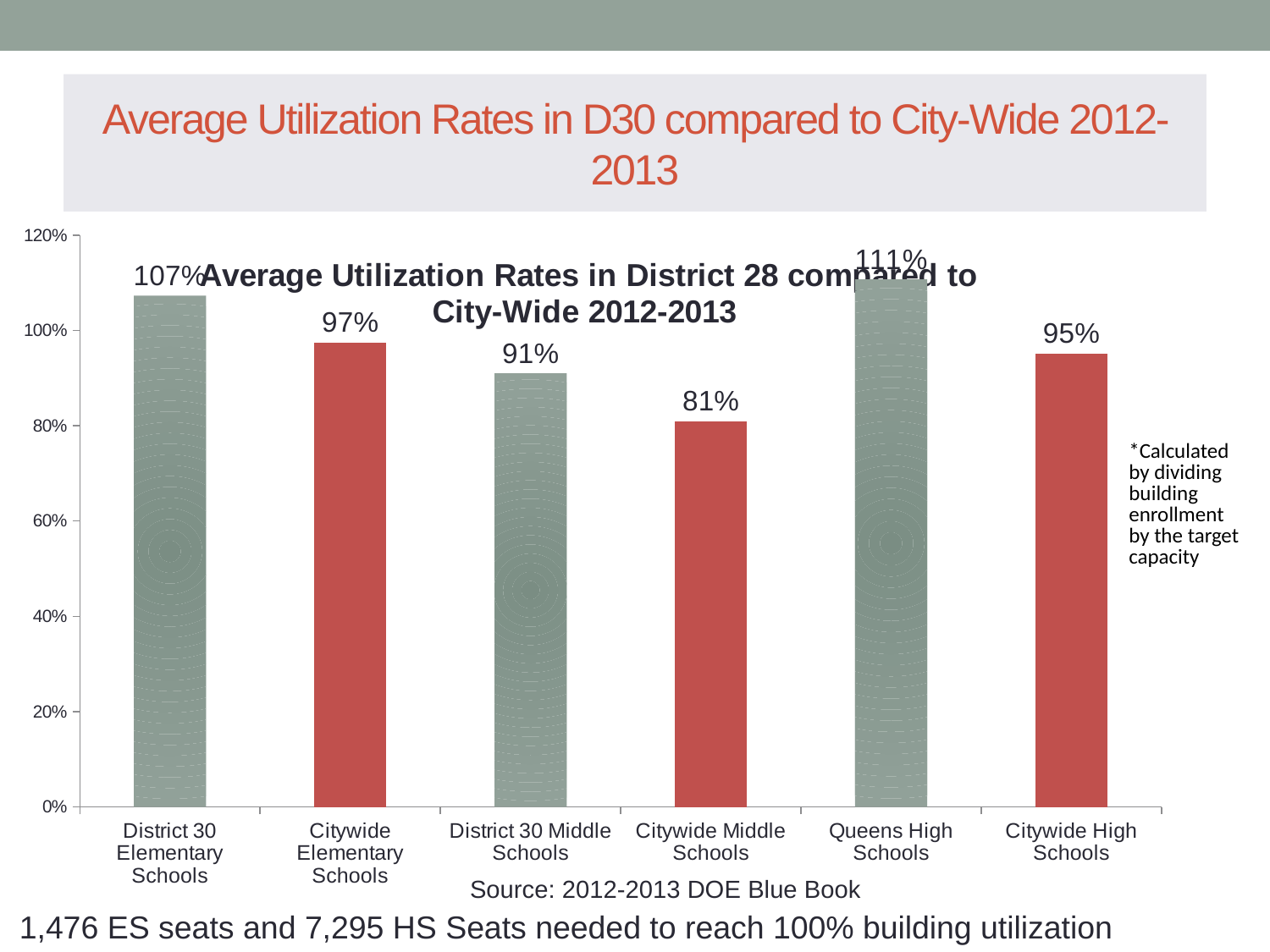
What is the source cited below the chart? 2012-2013 DOE Blue Book What is the difference between the utilization rates of District 30 Elementary Schools and Citywide Elementary Schools? 10% Which category has the highest utilization rate? Queens High Schools How many categories are shown on the x axis of the chart? 6 What is the average utilization rate for Queens High Schools? 111% Is the value for Citywide High Schools greater or less than 100%? less What is the average utilization rate for District 30 Elementary Schools? 107% Which category has the lowest utilization rate? Citywide Middle Schools What kind of chart is shown on the slide? bar chart Which is larger, the utilization rate for District 30 Middle Schools or for Citywide Middle Schools? District 30 Middle Schools What is the average utilization rate for Citywide Middle Schools? 81% What is the difference between the utilization rates of Queens High Schools and Citywide High Schools? 16%